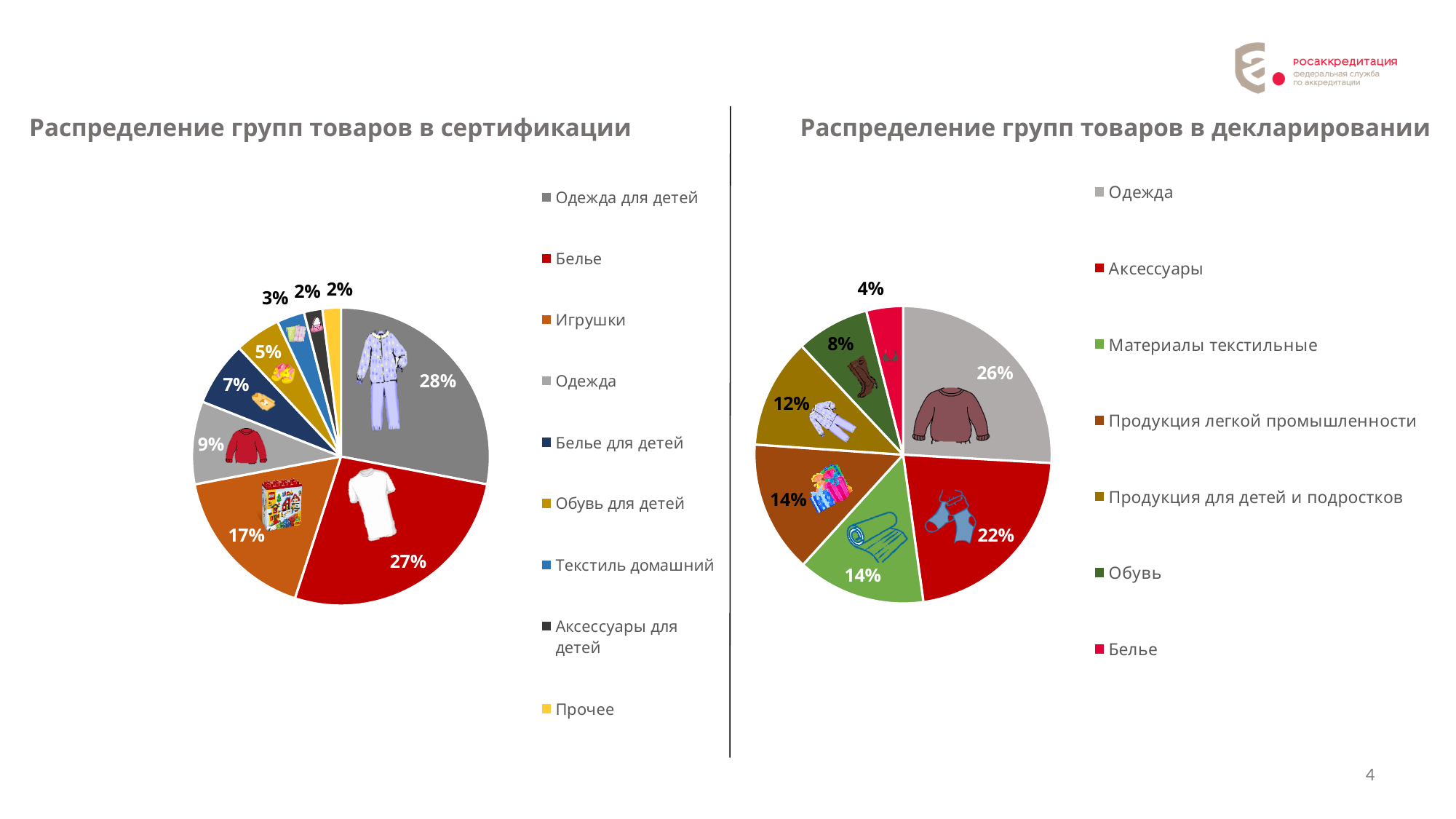
In the chart "Распределение групп товаров в декларировании", what is the difference between the shares of "Одежда" and "Белье"? 22% In the chart "Распределение групп товаров в сертификации", what is the difference between the shares of "Белье" and "Одежда"? 18% In the chart "Распределение групп товаров в сертификации", which category has the largest share? Одежда для детей In the chart "Распределение групп товаров в декларировании", which is larger: the share of "Одежда" or the share of "Продукция для детей и подростков"? Одежда What kind of chart is used on the left side of the slide, titled "Распределение групп товаров в сертификации"? Pie chart In the chart "Распределение групп товаров в сертификации", what share does "Игрушки" have? 17% How many categories does the legend of the chart "Распределение групп товаров в сертификации" list? 9 In the chart "Распределение групп товаров в декларировании", what share does "Аксессуары" have? 22% In the chart "Распределение групп товаров в декларировании", which category has the smallest share? Белье In the chart "Распределение групп товаров в сертификации", what share does "Одежда для детей" have? 28% How many categories does the legend of the chart "Распределение групп товаров в декларировании" list? 7